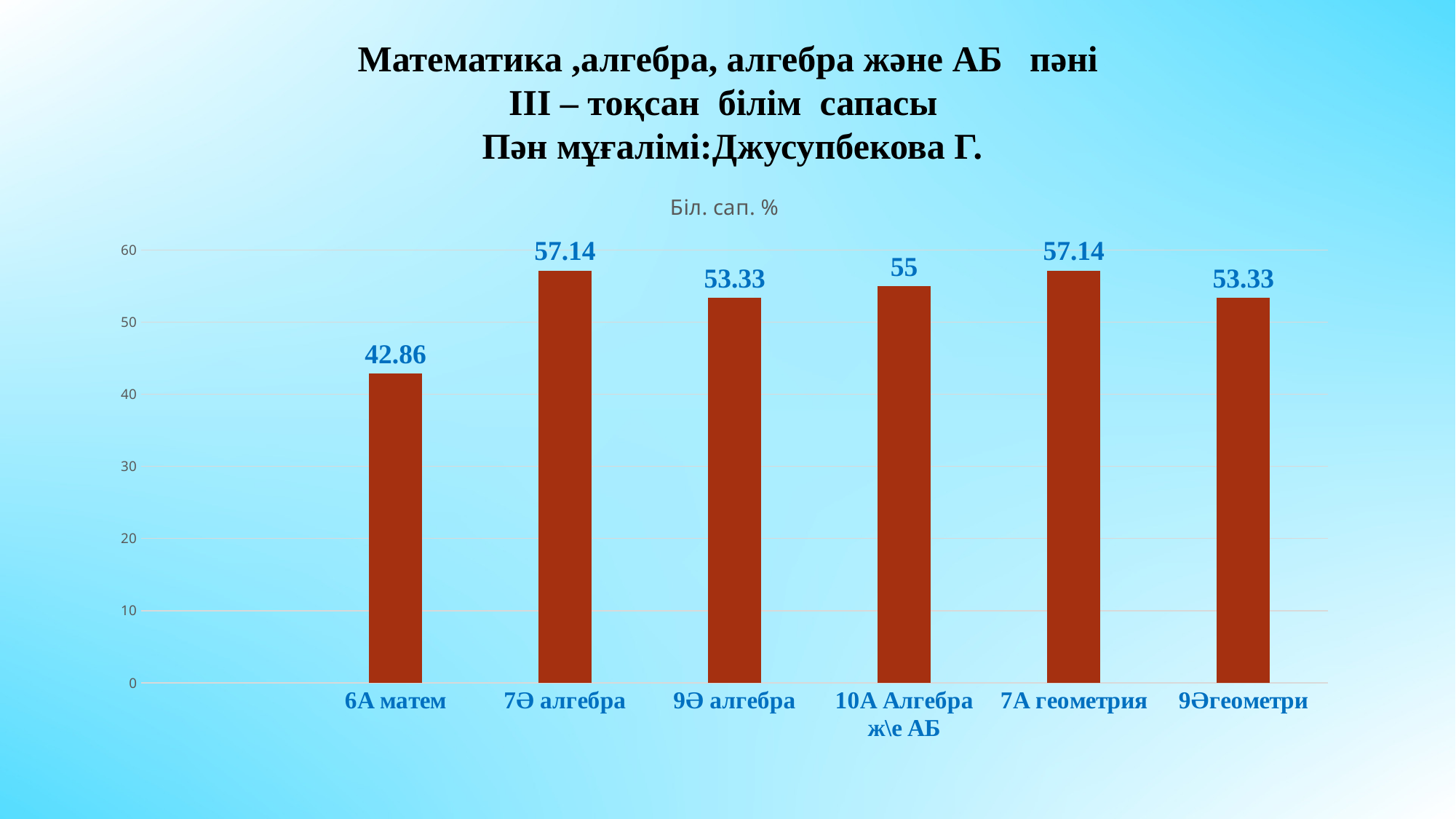
What is the difference between the values for 7Ә алгебра and 6А матем? 14.28 What is the difference between the values for 10А Алгебра ж\е АБ and 9Ә алгебра? 1.67 What is the value for 10А Алгебра ж\е АБ? 55 Which category has the lowest value? 6А матем What is the value for 6А матем? 42.86 Which is larger, the value for 7А геометрия or the value for 9Әгеометри? 7А геометрия Is the value for 6А матем greater or less than 50? less What kind of chart is shown on the slide? bar chart What is the value for 9Әгеометри? 53.33 What is the value for 7Ә алгебра? 57.14 What is the title shown directly above the chart's plot area? Біл. сап. % How many categories are shown on the x axis? 6